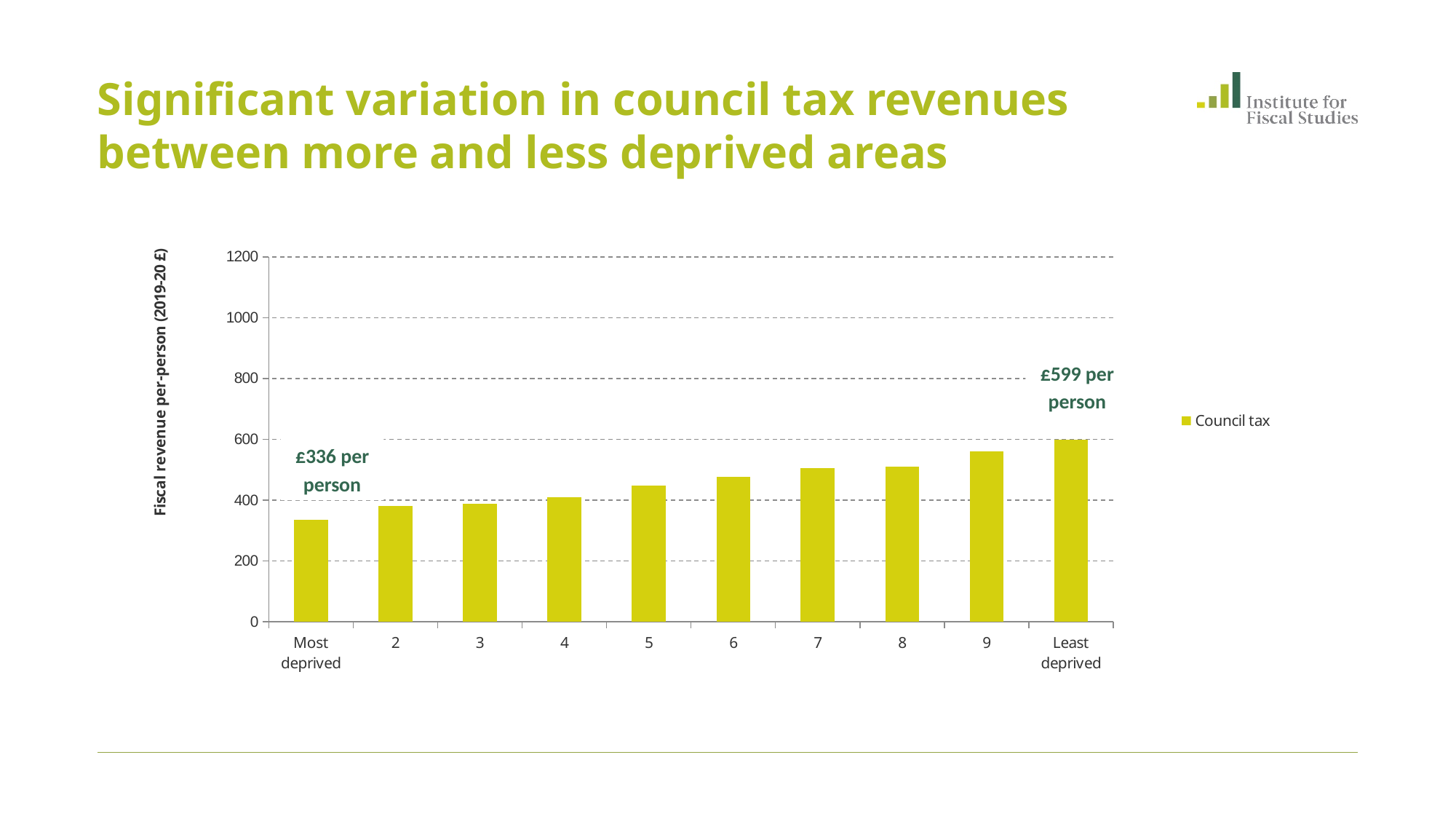
What is the difference in council tax revenue per person between the least deprived and most deprived deciles? £263 What kind of chart is shown on the slide? Bar chart How many deprivation categories are shown on the x axis? 10 What is the council tax revenue per person for the most deprived decile? £336 per person Which category has the lowest council tax revenue per person? Most deprived Is the value for decile 9 greater or less than 600? less Do the values rise or fall moving from the most deprived to the least deprived decile? Rise Is the value for decile 5 greater or less than 400? greater How many series does the legend list? 1 What is the council tax revenue per person for the least deprived decile? £599 per person Which category has the highest council tax revenue per person? Least deprived Which has higher council tax revenue per person: decile 2 or decile 9? 9